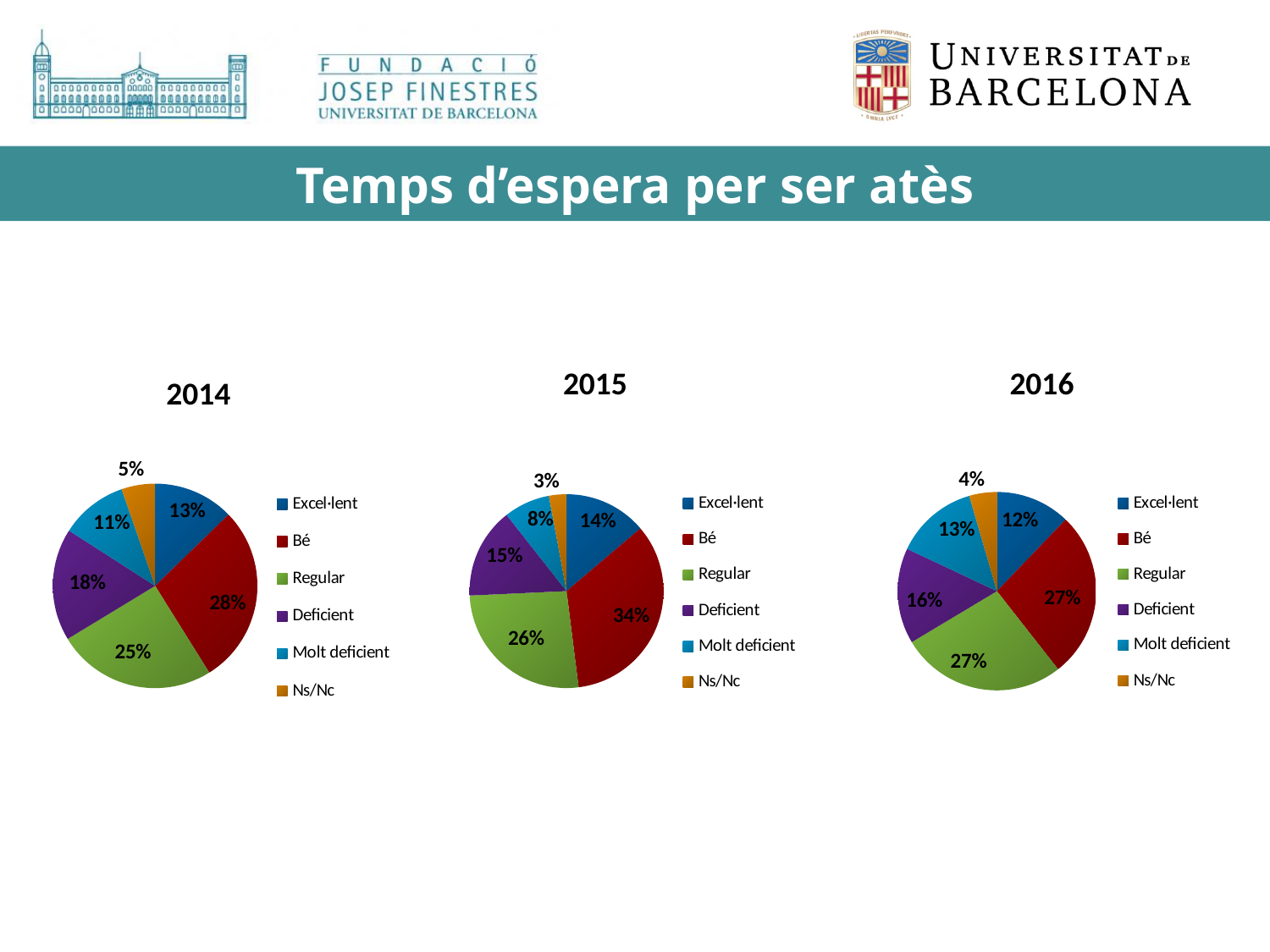
How many pie charts are shown on the slide? 3 In the 2015 pie chart, what share is labelled for Regular? 26% How many categories does the legend of the 2015 pie chart list? 6 What is the title of the slide containing the three pie charts? Temps d'espera per ser atès In the 2016 pie chart, which category has the smallest slice? Ns/Nc Which is larger: the Deficient share in the 2014 pie chart or the Deficient share in the 2016 pie chart? 2014 In the 2016 pie chart, what share is labelled for Molt deficient? 13% In the 2014 pie chart, which category has the smallest slice? Ns/Nc What is the difference between the Bé share in the 2015 pie chart and the Bé share in the 2014 pie chart? 6% In the 2014 pie chart, what share is labelled for Bé? 28% What type of chart is used for the 2016 data? Pie chart In the 2015 pie chart, which category has the largest slice? Bé